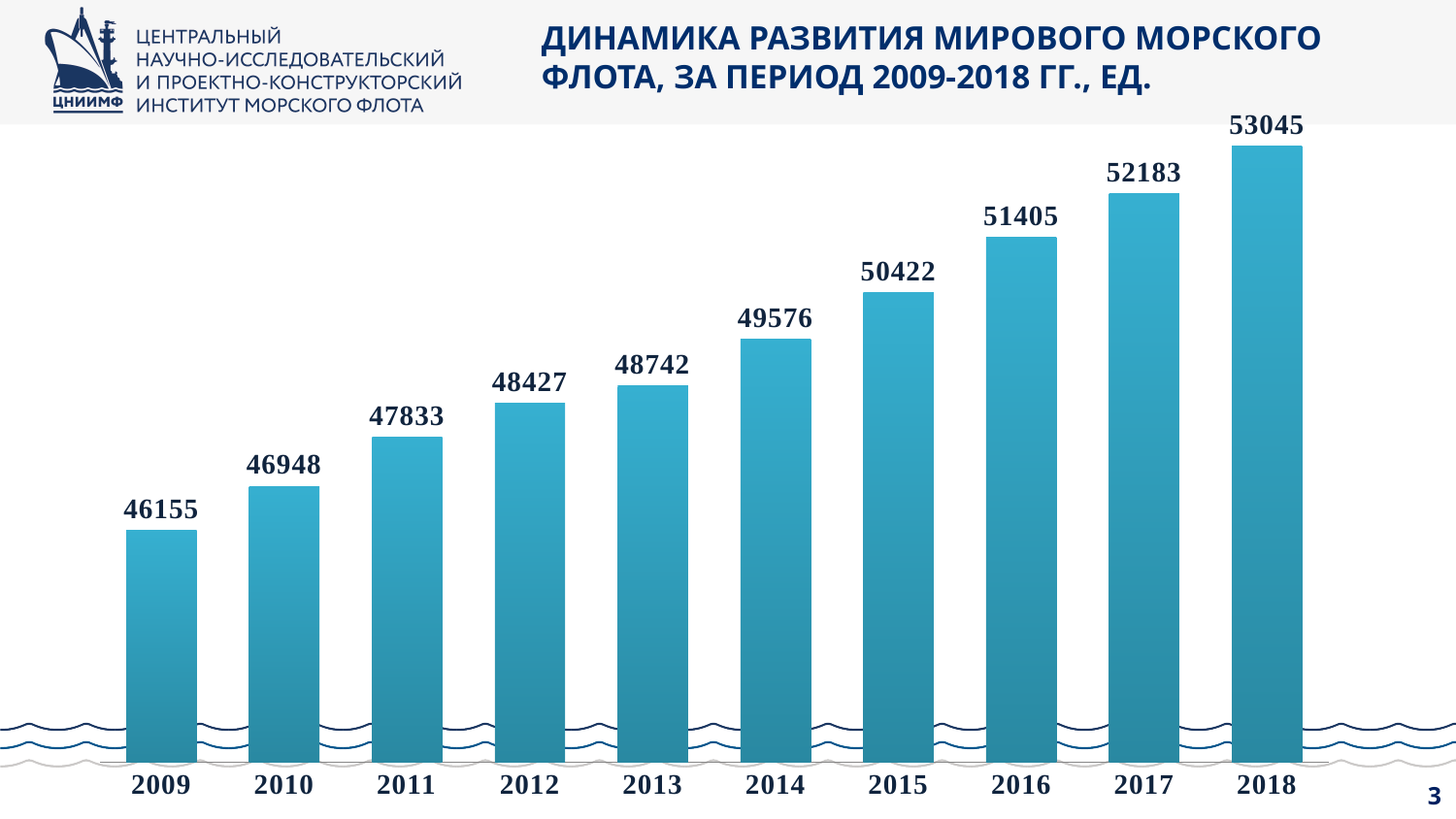
What kind of chart is this? bar chart What is the value for 2011? 47833 What is the difference between the values for 2018 and 2009? 6890 How many years are shown on the chart? 10 Do the values rise or fall from 2009 to 2018? rise What is the value for 2009? 46155 What is the value for 2014? 49576 What is the difference between the values for 2013 and 2012? 315 Which year has the highest value? 2018 What is the value for 2018? 53045 Which is larger, the value for 2015 or the value for 2016? 2016 Which year has the lowest value? 2009